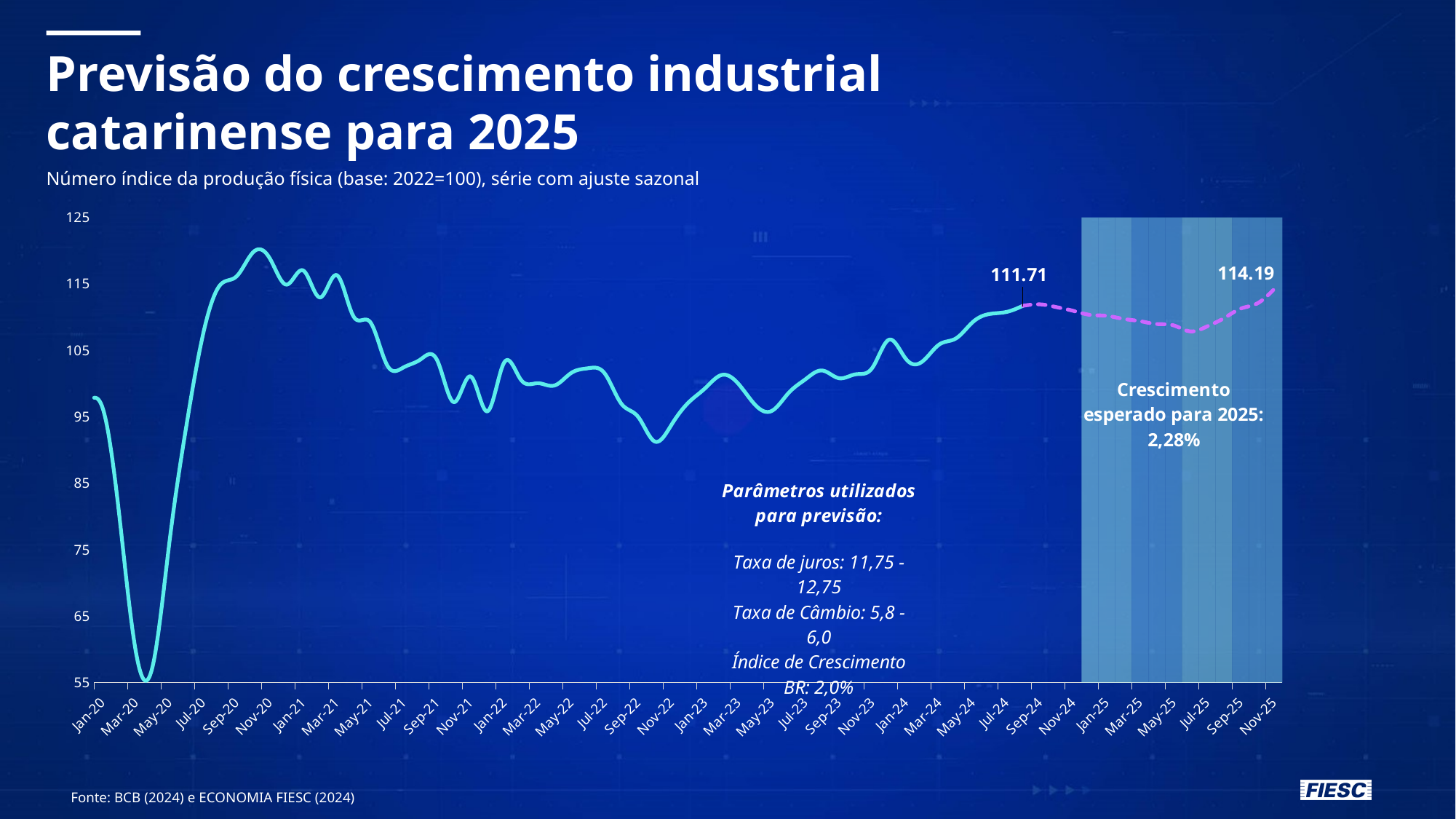
Is the value of the index around Oct-22 greater or less than 95? less What kind of chart is shown on the slide? line chart Is the peak value of the index in late 2020 greater or less than 115? greater What is the value of the data label at the end of the forecast (dashed) line, at Nov-25? 114.19 What is the value of the data label shown where the solid line ends and the dashed forecast line begins, around Aug-24? 111.71 Which is larger: the index value around Nov-20 or the index value at Jan-20? Nov-20 In which year does the index reach its lowest point? 2020 Does the forecast line rise or fall between Jul-25 and Nov-25? rise Does the index rise or fall between Jan-20 and Apr-20? fall Is the value of the index around Apr-20 greater or less than 65? less What expected growth for 2025 is stated in the shaded forecast area of the chart? 2,28% What is the difference between the two labelled values, 114.19 and 111.71? 2.48